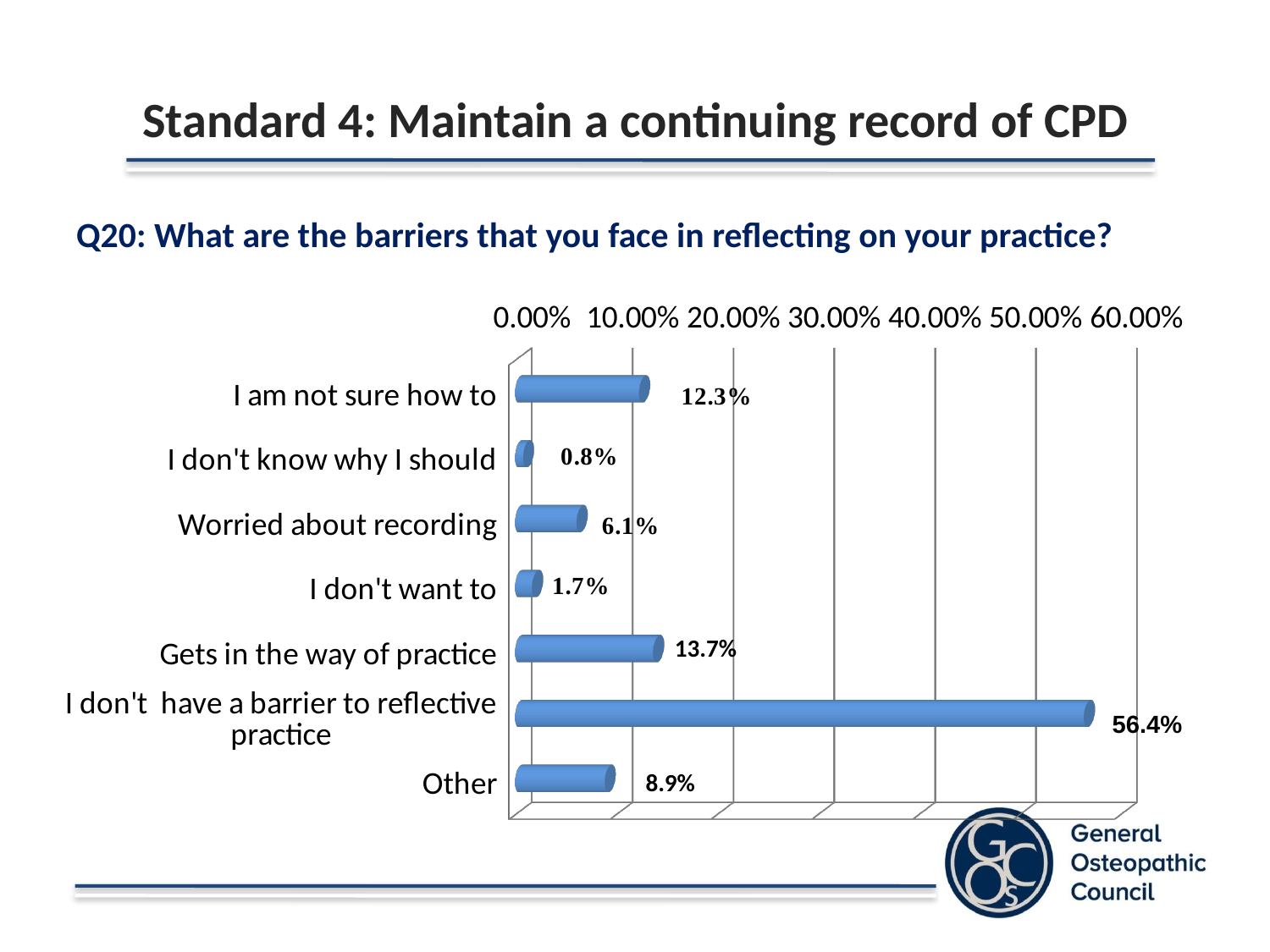
What is the difference between 'Gets in the way of practice' and 'I am not sure how to'? 1.4% Which category has the lowest value? I don't know why I should What percentage selected 'Other' as a barrier? 8.9% What kind of chart is shown on the slide? Bar chart What is the value for 'Worried about recording'? 6.1% What percentage of respondents said 'I am not sure how to'? 12.3% Is the value for 'I don't have a barrier to reflective practice' greater or less than 50.00%? greater Which barrier category has the highest value? I don't have a barrier to reflective practice How many barrier categories are shown in the chart? 7 What is the value for 'Gets in the way of practice'? 13.7% Which is larger: 'Worried about recording' or 'I don't want to'? Worried about recording What is the maximum value shown on the percentage axis? 60.00%